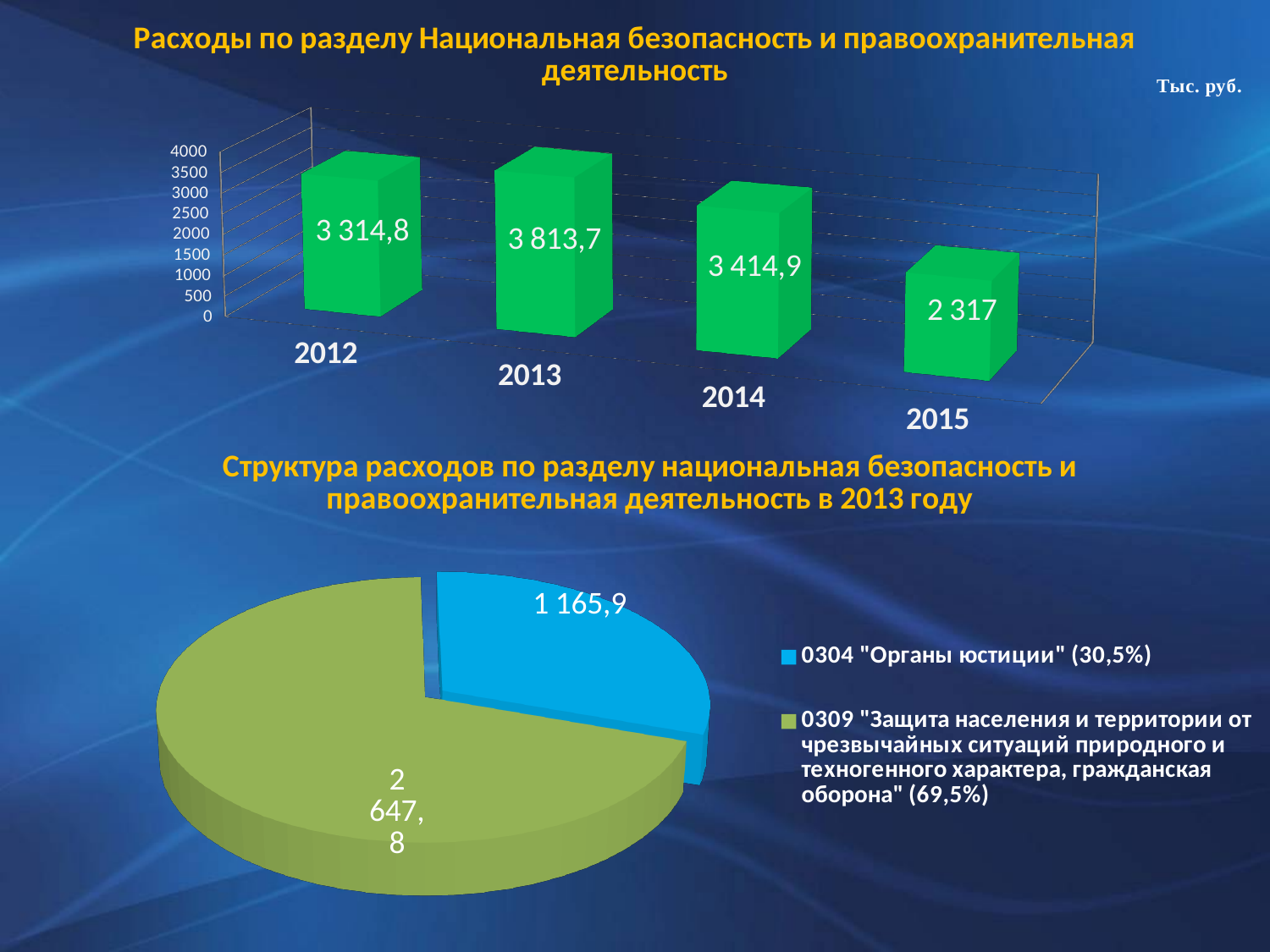
What kind of chart is the top chart on the slide? bar chart In the top bar chart, what is the value for 2013? 3 813,7 In the top bar chart, how many years are shown? 4 In the top bar chart, which year has the highest value? 2013 In the top bar chart, which year has the lowest value? 2015 How many entries does the legend of the bottom pie chart list? 2 In the bottom pie chart, what share does 0309 "Защита населения и территории от чрезвычайных ситуаций природного и техногенного характера, гражданская оборона" have? 69,5% In the top bar chart, what is the difference between the values for 2013 and 2012? 498,9 In the top bar chart, do the values rise or fall from 2013 to 2015? fall In the top bar chart, which is larger, the value for 2012 or the value for 2014? 2014 In the bottom pie chart, what is the value for 0304 "Органы юстиции"? 1 165,9 In the top bar chart, what is the value for 2015? 2 317